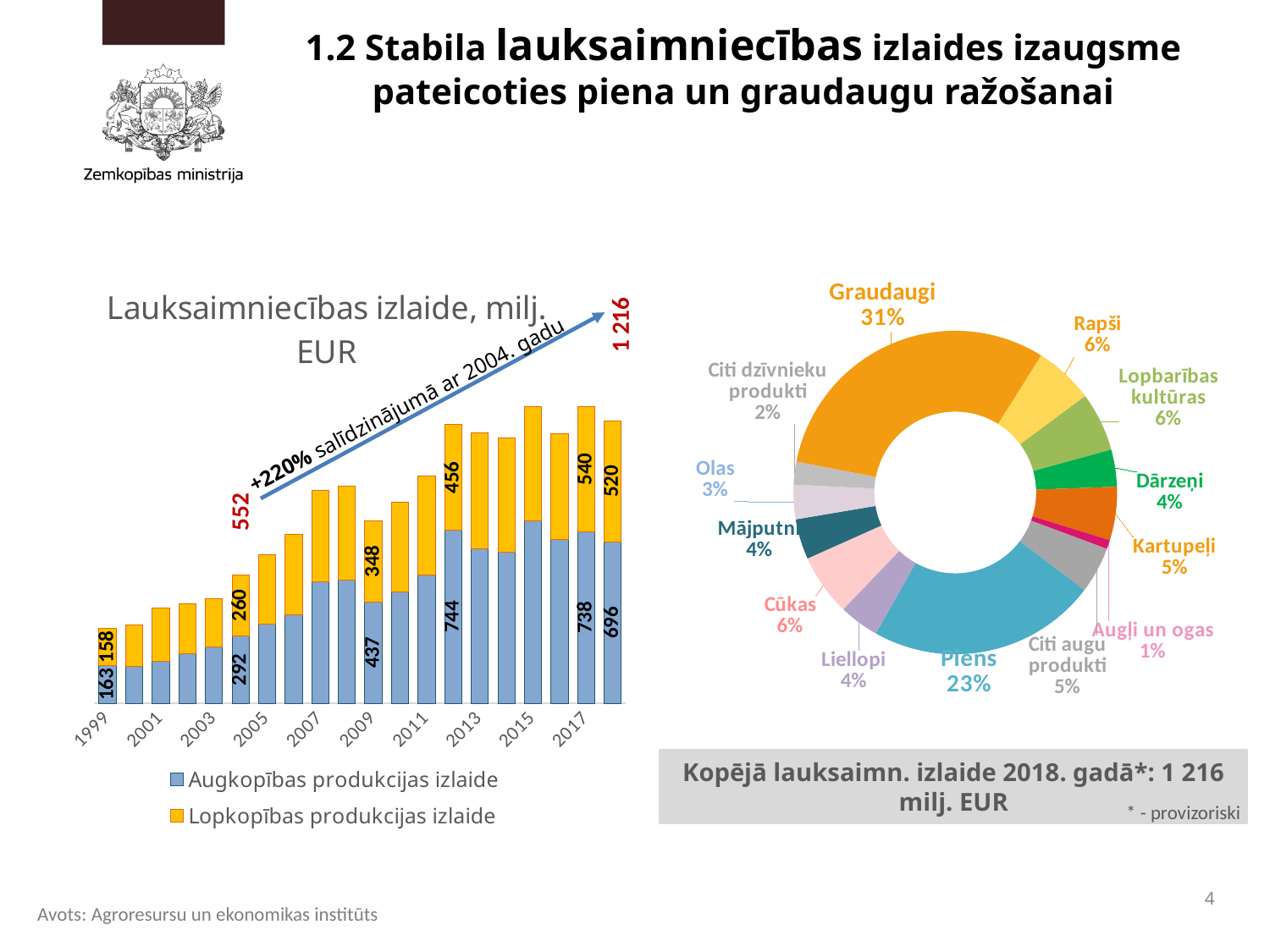
In the left chart "Lauksaimniecības izlaide, milj. EUR", how many series does the legend list? 2 What kind of chart is the left chart titled "Lauksaimniecības izlaide, milj. EUR"? Stacked bar chart In the left chart "Lauksaimniecības izlaide, milj. EUR", what is the total output shown for 2004? 552 In the left chart "Lauksaimniecības izlaide, milj. EUR", which series is larger in 2013: Augkopības produkcijas izlaide or Lopkopības produkcijas izlaide? Augkopības produkcijas izlaide In the doughnut chart on the right, which category has the largest share? Graudaugi In the left chart "Lauksaimniecības izlaide, milj. EUR", what is the total output shown for 2018? 1 216 In the left chart "Lauksaimniecības izlaide, milj. EUR", what is the value of Lopkopības produkcijas izlaide in 2018? 520 In the left chart "Lauksaimniecības izlaide, milj. EUR", by how much did Augkopības produkcijas izlaide fall from 2017 (738) to 2018 (696)? 42 In the doughnut chart on the right, what share does Piens have? 23% In the left chart "Lauksaimniecības izlaide, milj. EUR", does total agricultural output generally rise or fall from 1999 to 2018? Rise In the left chart "Lauksaimniecības izlaide, milj. EUR", what is the value of Augkopības produkcijas izlaide in 1999? 163 In the doughnut chart on the right, which category has the smallest share? Augļi un ogas